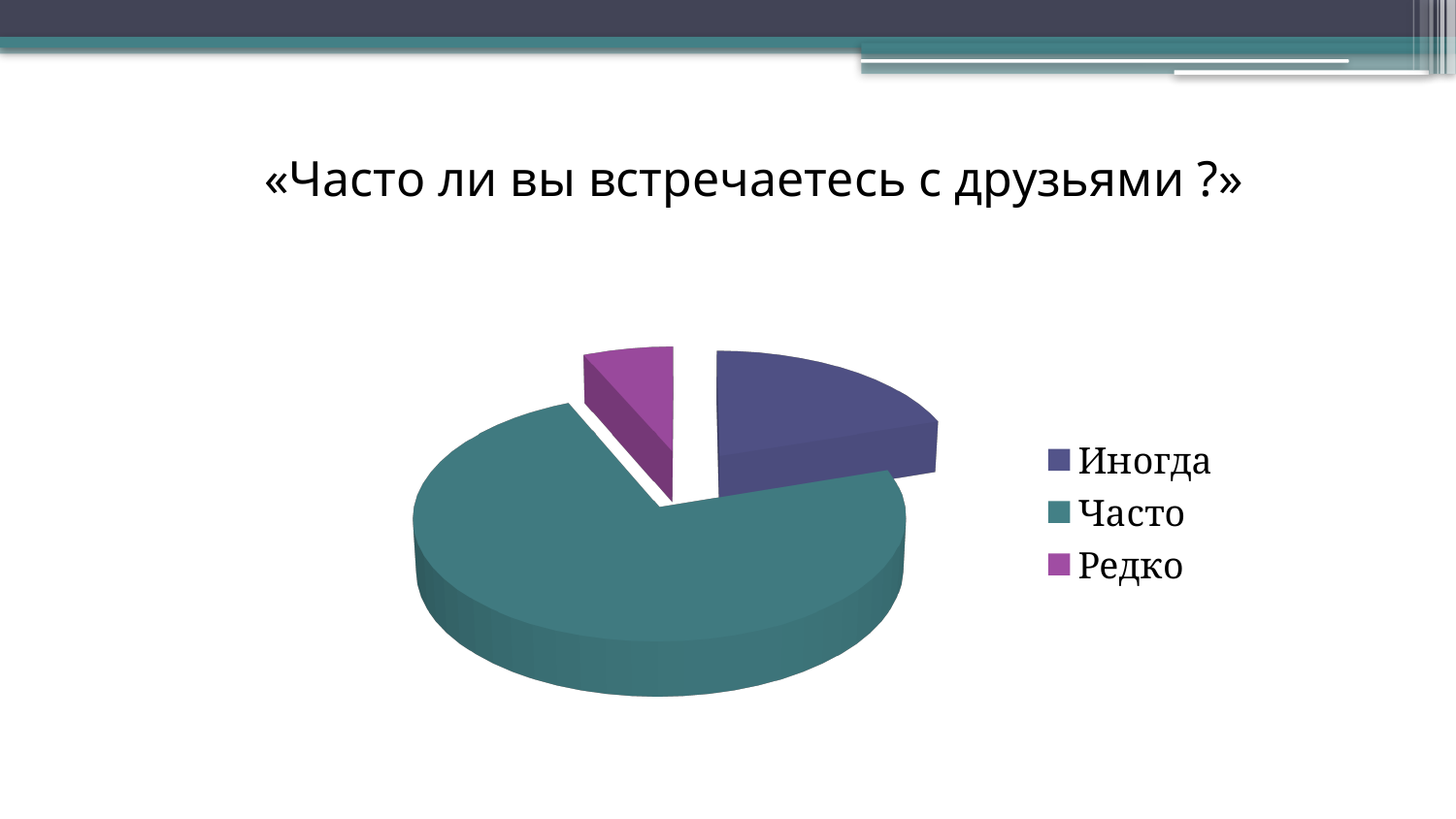
Does the Часто slice take up more or less than half of the pie? more How many entries does the legend list? 3 How many slices does the pie chart have? 3 Which category has the smallest slice of the pie? Редко Which category has the largest slice of the pie? Часто Which slice is larger, Иногда or Редко? Иногда What kind of chart is shown on the slide? pie chart Which slice is larger, Часто or Иногда? Часто What colour is the Часто slice in the pie chart? teal What is the title of the chart on the slide? «Часто ли вы встречаетесь с друзьями ?»